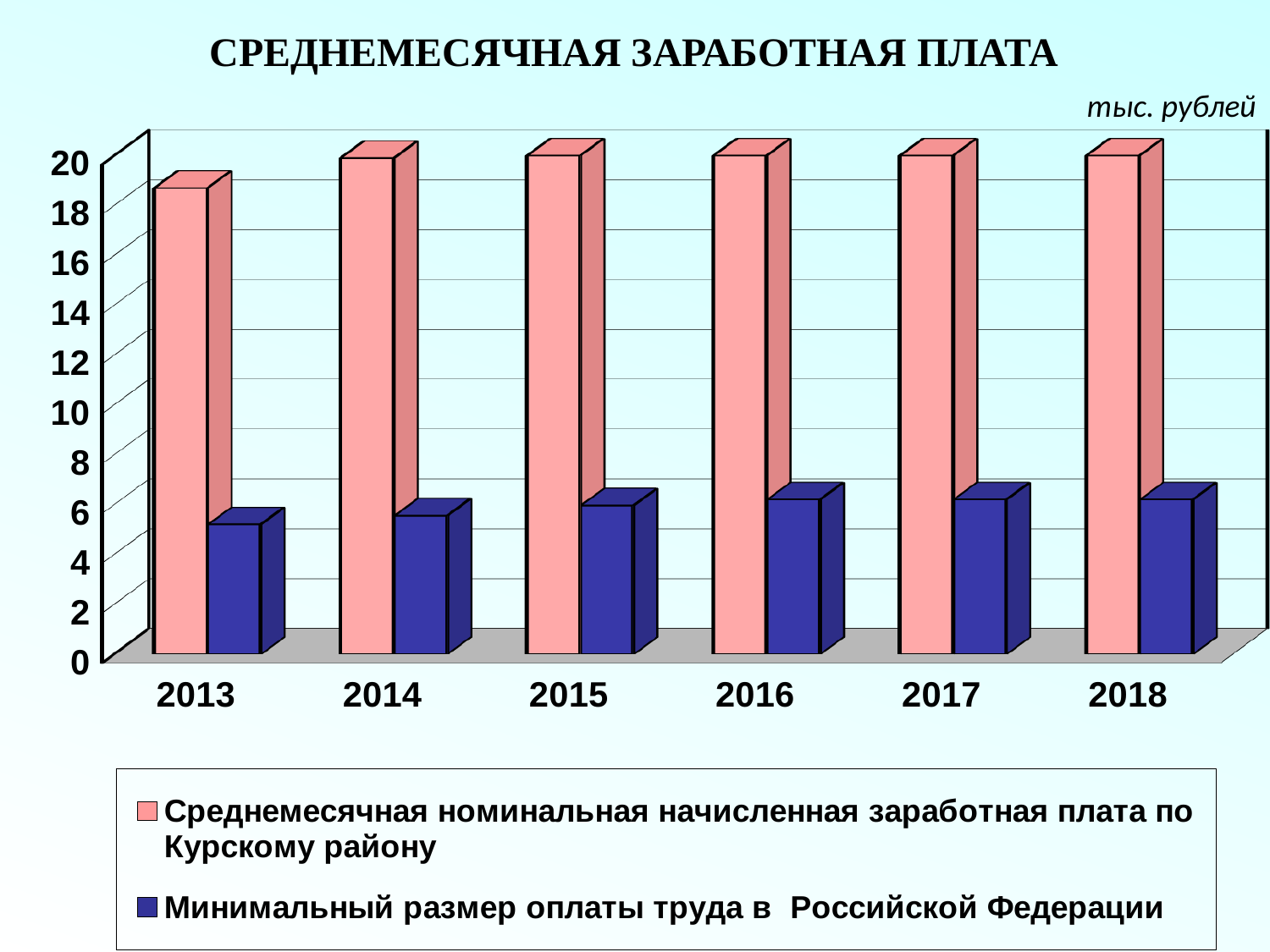
Do the values for Минимальный размер оплаты труда в Российской Федерации rise or fall from 2013 to 2018? rise In 2016, which is larger: Среднемесячная номинальная начисленная заработная плата по Курскому району or Минимальный размер оплаты труда в Российской Федерации? Среднемесячная номинальная начисленная заработная плата по Курскому району In what units are the values on the chart given? тыс. рублей What is the title of the chart? СРЕДНЕМЕСЯЧНАЯ ЗАРАБОТНАЯ ПЛАТА In which year is the value for Среднемесячная номинальная начисленная заработная плата по Курскому району the lowest? 2013 How many series does the legend list? 2 In which year is the value for Минимальный размер оплаты труда в Российской Федерации the lowest? 2013 Is the value for Среднемесячная номинальная начисленная заработная плата по Курскому району in 2013 greater or less than 18? greater What kind of chart is shown on the slide? bar chart Is the value for Минимальный размер оплаты труда в Российской Федерации in 2018 greater or less than 4? greater Is the value for Минимальный размер оплаты труда в Российской Федерации in 2013 greater or less than 6? less How many years are shown on the x axis of the chart? 6